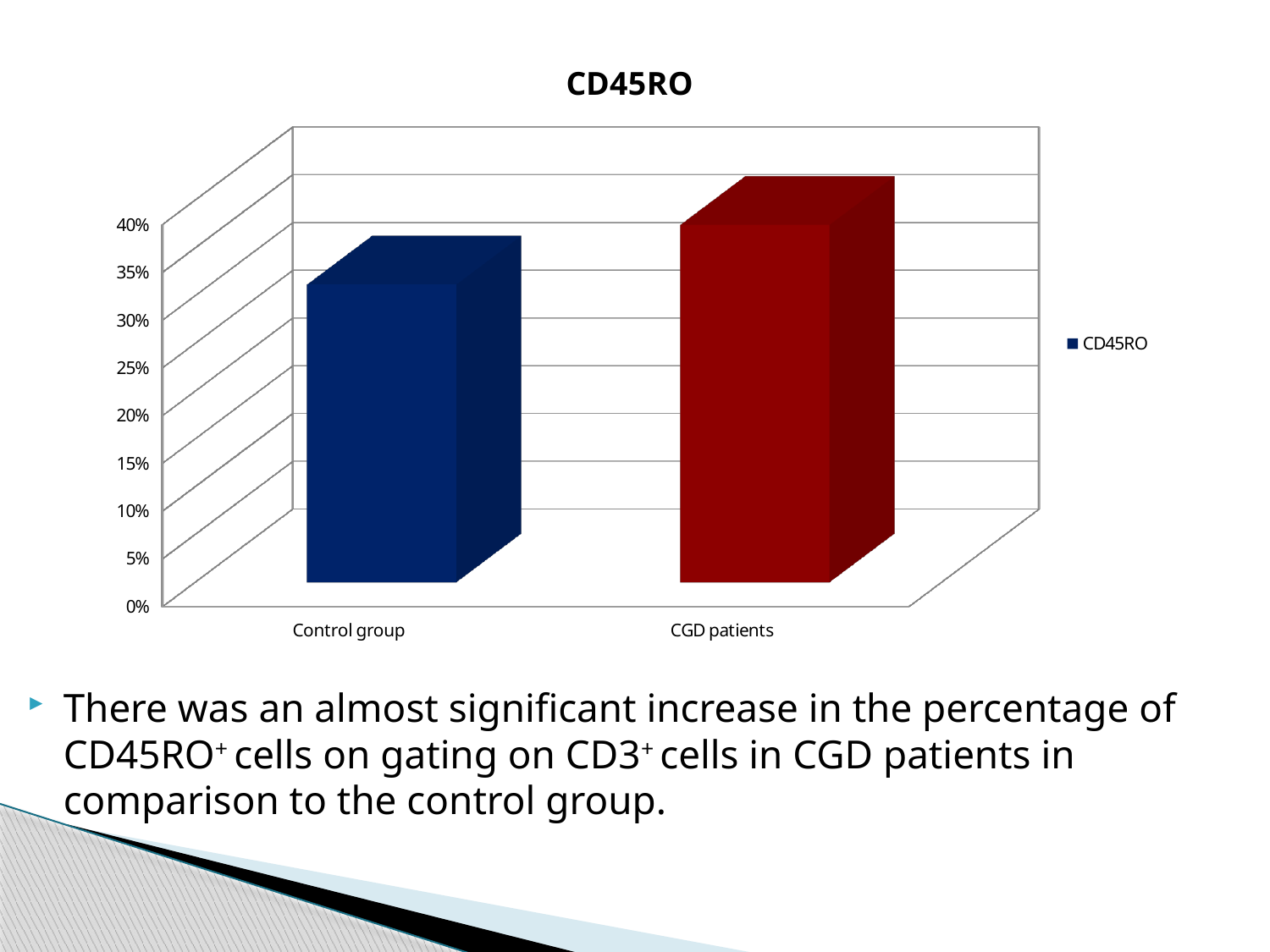
Is the value for Control group greater or less than 40%? less Which category has the highest value in the chart? CGD patients How many categories are shown on the x axis of the chart? 2 Is the value for CGD patients greater or less than 30%? greater What colour is the bar for CGD patients? Red How many series does the chart legend list? 1 Is the value for Control group greater or less than 20%? greater What kind of chart is shown on the slide? Bar chart Which category has the lowest value in the chart? Control group What is the title of the chart? CD45RO Which is larger, the value for Control group or the value for CGD patients? CGD patients